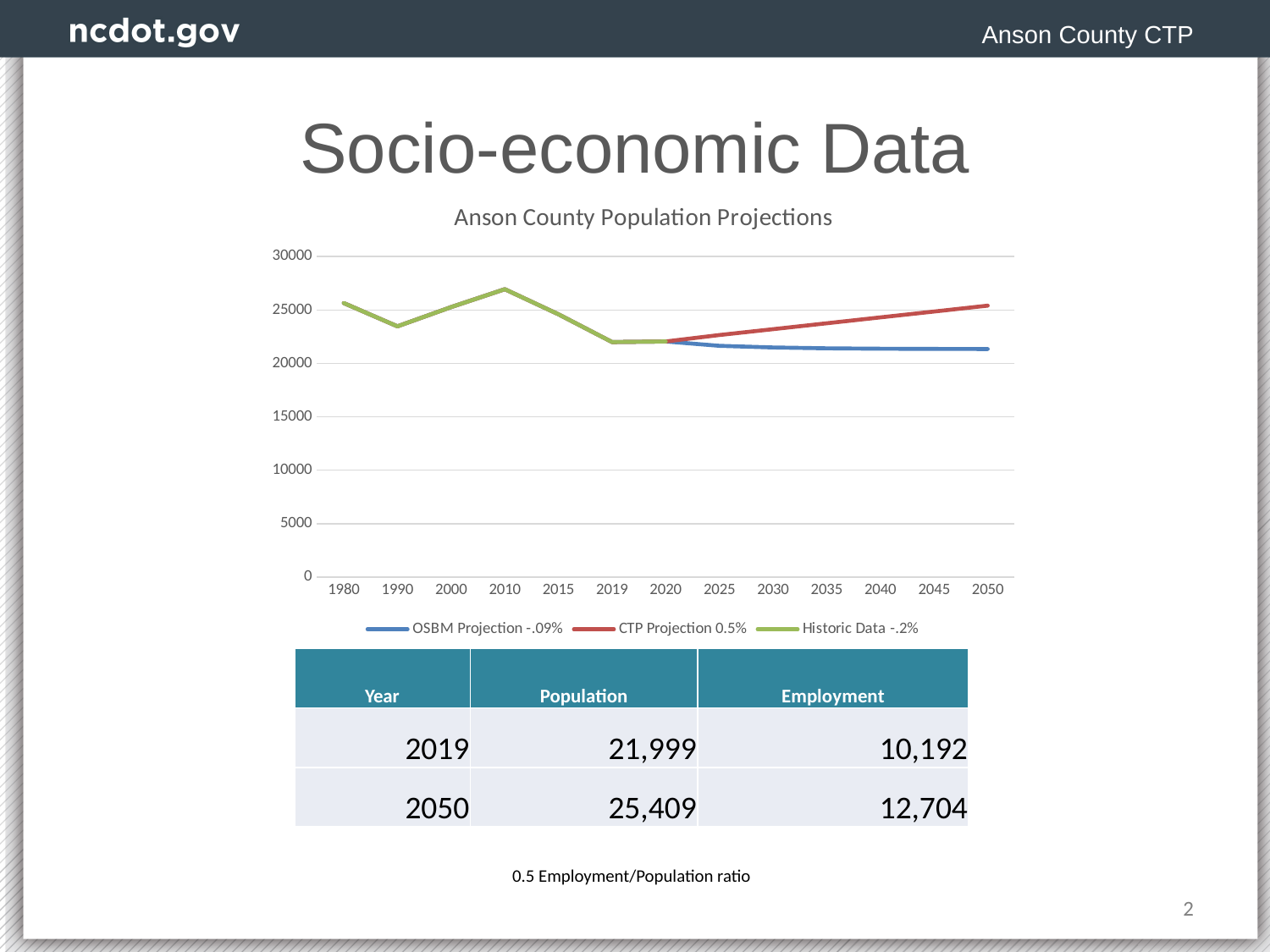
What kind of chart is shown on the slide? line chart At 2050, which series has the larger value, CTP Projection 0.5% or OSBM Projection -.09%? CTP Projection 0.5% Does the OSBM Projection -.09% series rise or fall from 2020 to 2050? fall What is the title of the chart? Anson County Population Projections Is the Historic Data value for 1990 greater or less than 25000? less Is the Historic Data value for 2010 greater or less than 25000? greater Is the OSBM Projection value for 2050 greater or less than 20000? greater How many series does the chart legend list? 3 In which year does the Historic Data series reach its highest value? 2010 How many year labels are shown along the x axis of the chart? 13 Which series is drawn in red in the chart? CTP Projection 0.5%